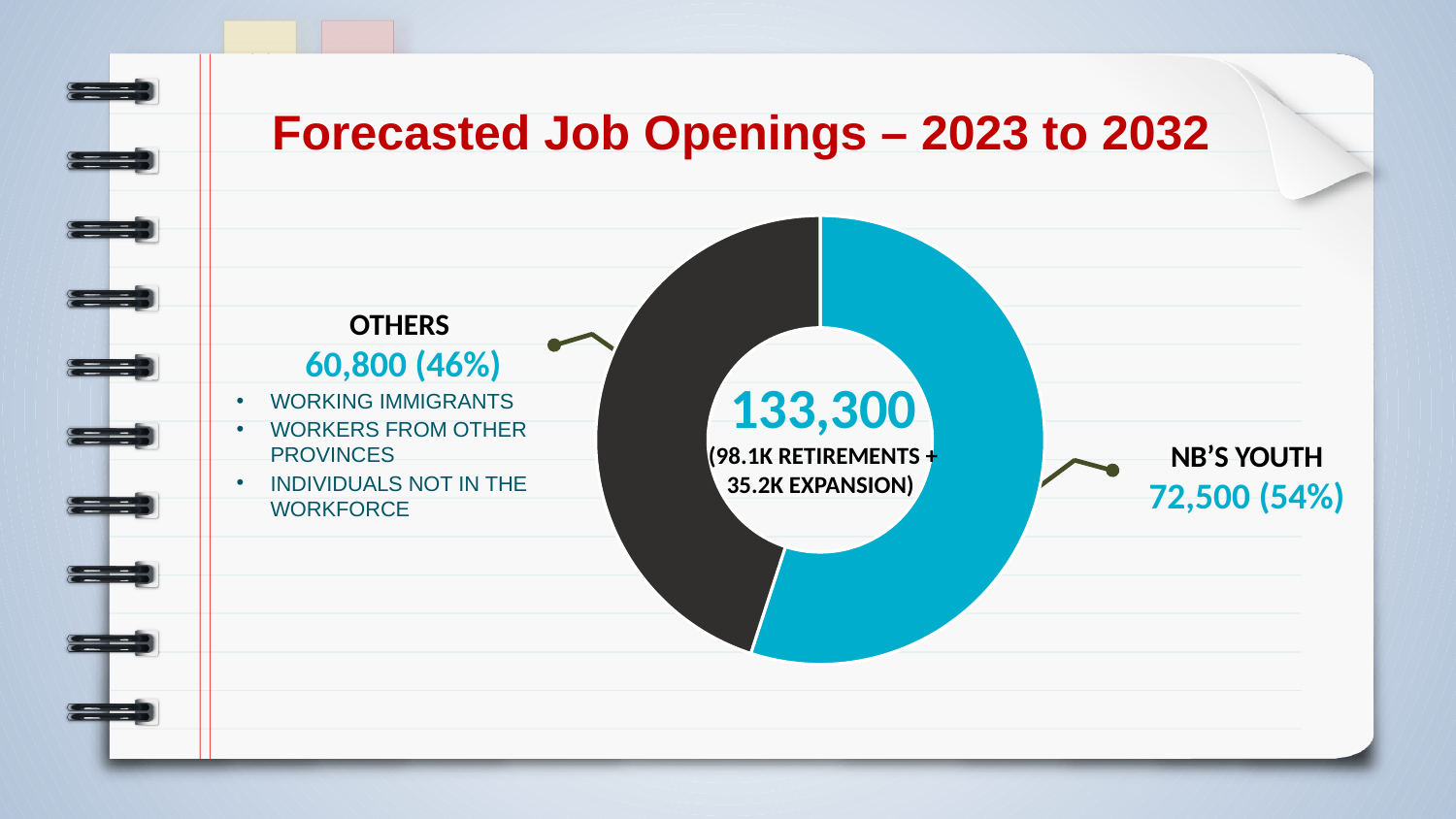
Which category has the largest share of forecasted job openings? NB's Youth What share of the forecasted job openings is attributed to Others? 46% Which segment is larger, NB's Youth or Others? NB's Youth How many segments does the chart have? 2 What kind of chart is shown on the slide? Pie chart (donut) What is the total number of forecasted job openings shown in the centre of the chart? 133,300 What is the forecasted number of job openings for Others? 60,800 What is the forecasted number of job openings for NB's Youth? 72,500 What is the difference in job openings between NB's Youth and Others? 11,700 Which category has the smallest share of forecasted job openings? Others What share of the forecasted job openings is attributed to NB's Youth? 54% What is the title of the chart? Forecasted Job Openings – 2023 to 2032